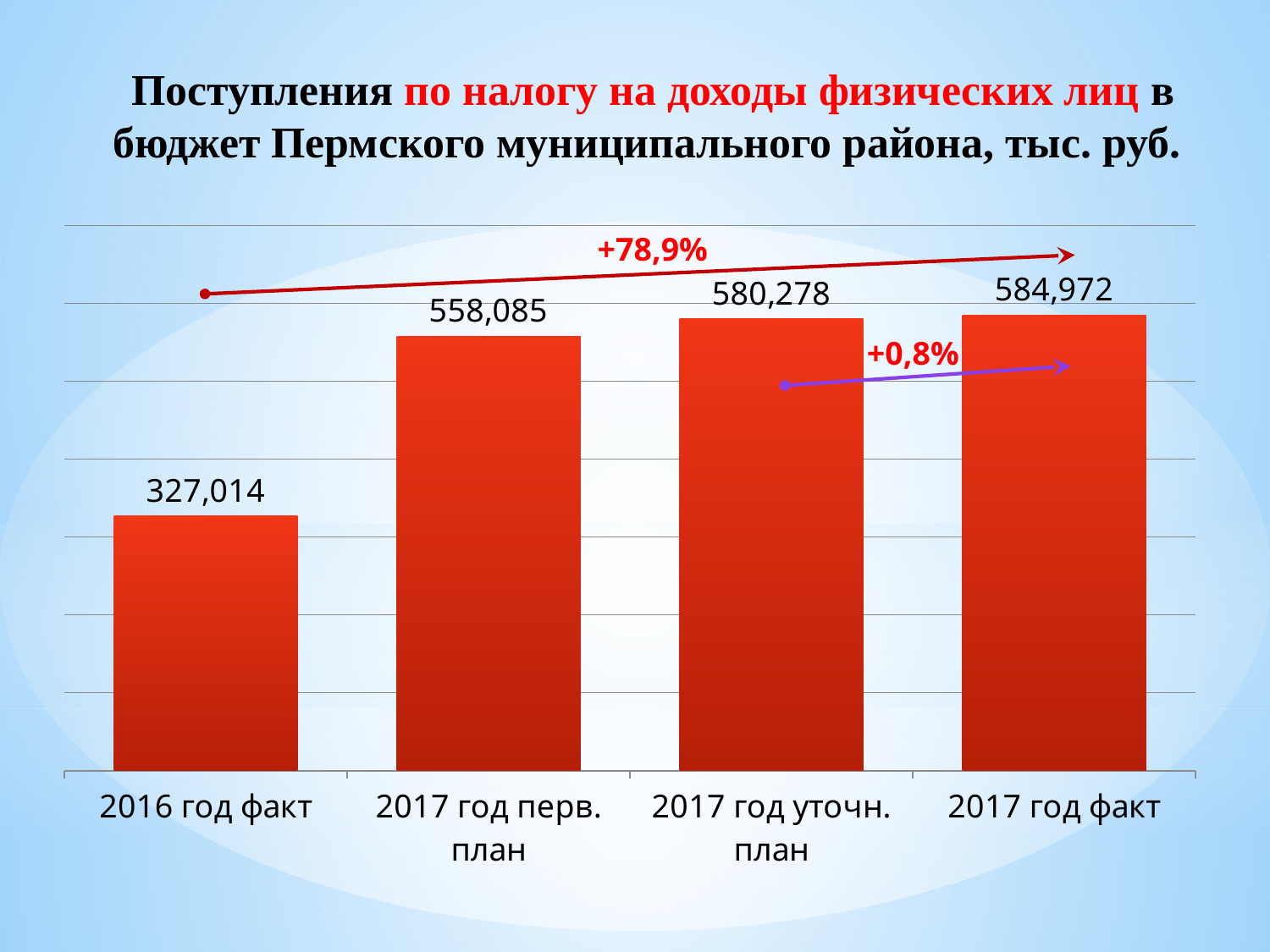
What is the value for 2017 год факт? 584,972 What is the difference between the values for 2017 год факт and 2016 год факт? 257,958 What is the value for 2017 год перв. план? 558,085 Which category has the lowest value? 2016 год факт How many categories are shown in the chart? 4 What is the difference between the values for 2017 год уточн. план and 2017 год перв. план? 22,193 What kind of chart is shown on the slide? Bar chart What is the value for 2016 год факт? 327,014 Which is larger, the value for 2017 год перв. план or the value for 2016 год факт? 2017 год перв. план What percentage change is shown by the red arrow from 2016 год факт to 2017 год факт? +78,9% What is the value for 2017 год уточн. план? 580,278 Which category has the highest value? 2017 год факт